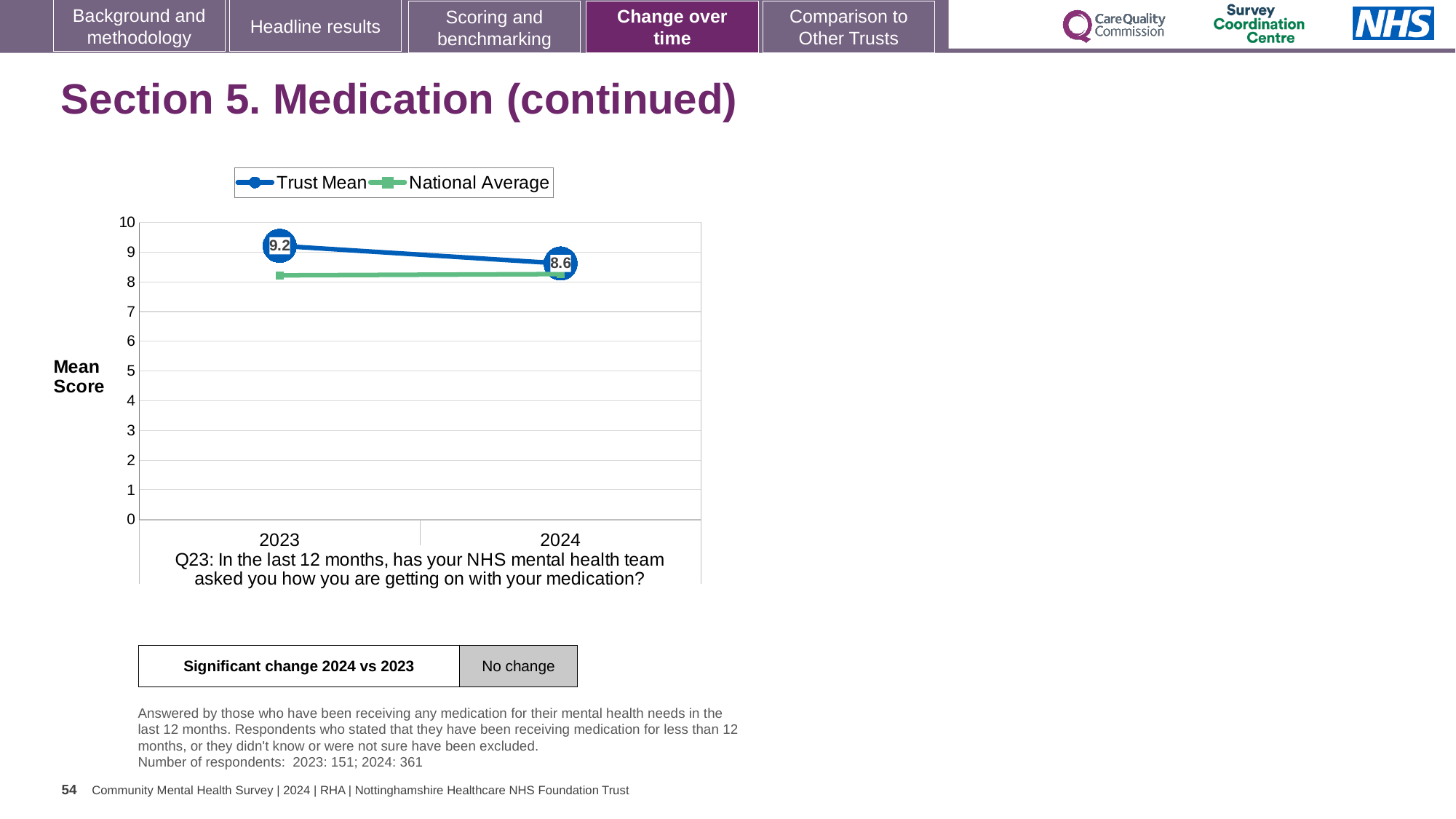
How many years are shown on the x axis? 2 What kind of chart is shown on the slide? line chart What is the label on the y axis of the chart? Mean Score Which year has the higher Trust Mean, 2023 or 2024? 2023 Is the National Average value for 2023 greater or less than 9? less By how much did the Trust Mean change from 2023 to 2024? 0.6 Is the Trust Mean value for 2023 greater or less than 9? greater What is the Trust Mean value for 2024? 8.6 What is the Trust Mean value for 2023? 9.2 In 2024, which is higher, the Trust Mean or the National Average? Trust Mean How many series does the legend list? 2 Does the Trust Mean rise or fall from 2023 to 2024? fall